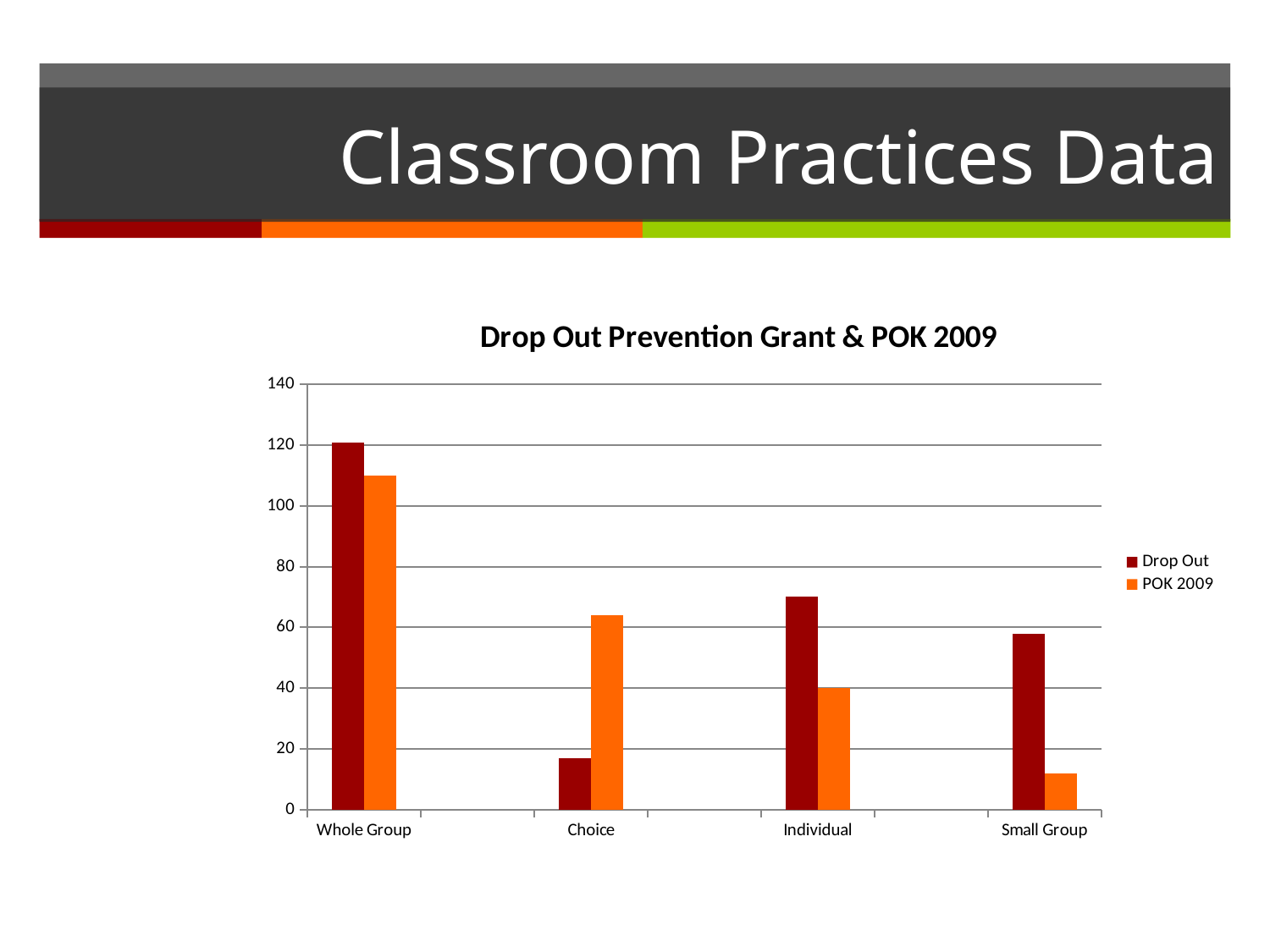
For Choice, which series has the larger value, Drop Out or POK 2009? POK 2009 Is the POK 2009 value for Small Group greater or less than 20? less Which category has the highest POK 2009 value? Whole Group Which category has the lowest POK 2009 value? Small Group Is the Drop Out value for Whole Group greater or less than 100? greater How many series does the legend list? 2 What kind of chart is shown on the slide? bar chart For Individual, which series has the larger value, Drop Out or POK 2009? Drop Out What is the title of the chart? Drop Out Prevention Grant & POK 2009 How many categories are shown on the x axis? 4 Which category has the highest Drop Out value? Whole Group Which category has the lowest Drop Out value? Choice